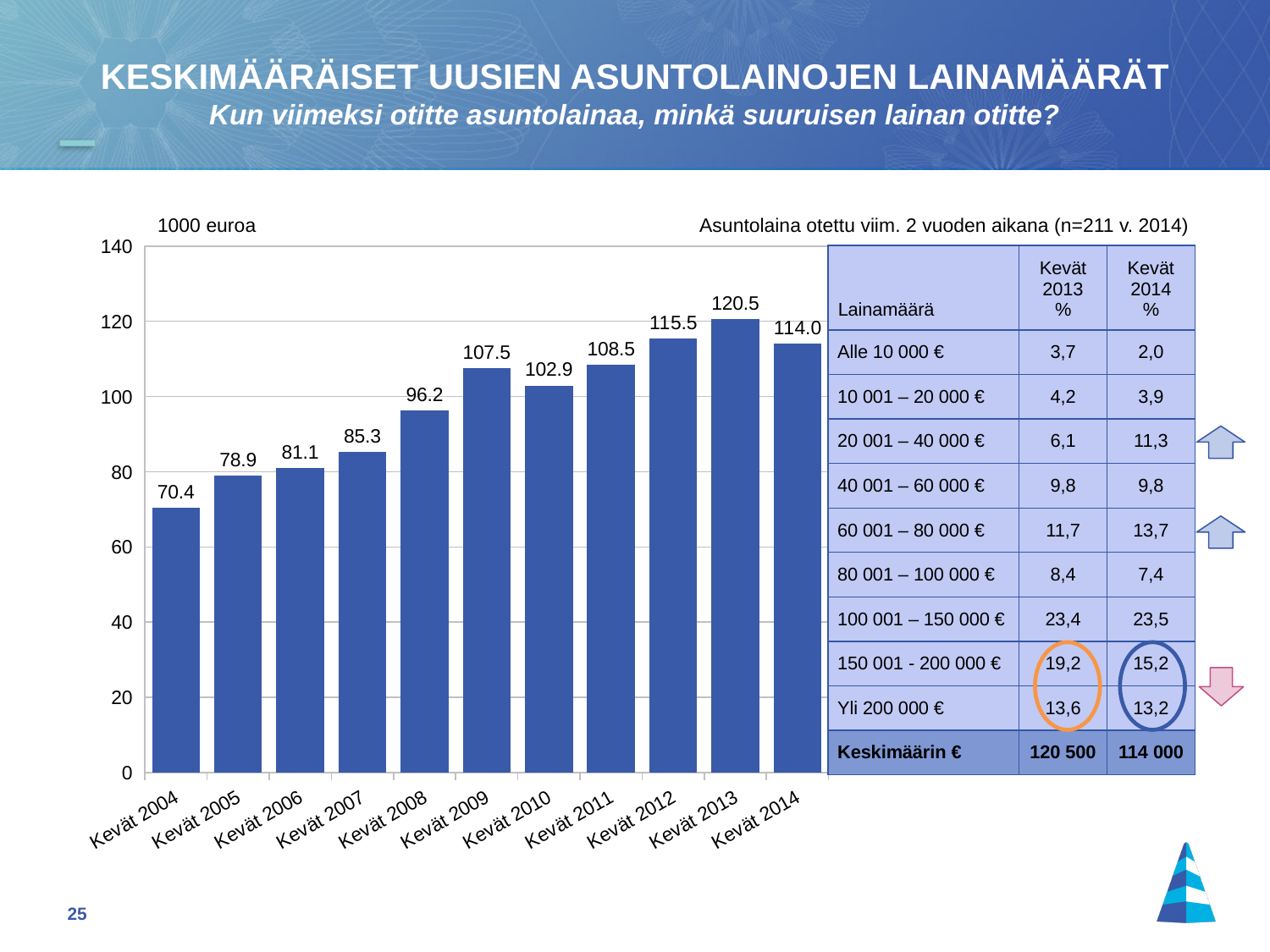
Which is larger, the value for Kevät 2009 or the value for Kevät 2010? Kevät 2009 Is the value for Kevät 2012 greater or less than 100? greater What is the difference between the values for Kevät 2013 and Kevät 2014? 6.5 What is the value for Kevät 2010? 102.9 What is the value for Kevät 2014? 114.0 What unit label is shown above the y axis of the chart? 1000 euroa How many bars are shown in the chart? 11 What is the difference between the values for Kevät 2008 and Kevät 2007? 10.9 What is the value for Kevät 2004? 70.4 Which year has the highest bar? Kevät 2013 Which year has the lowest bar? Kevät 2004 What kind of chart is shown on the slide? bar chart